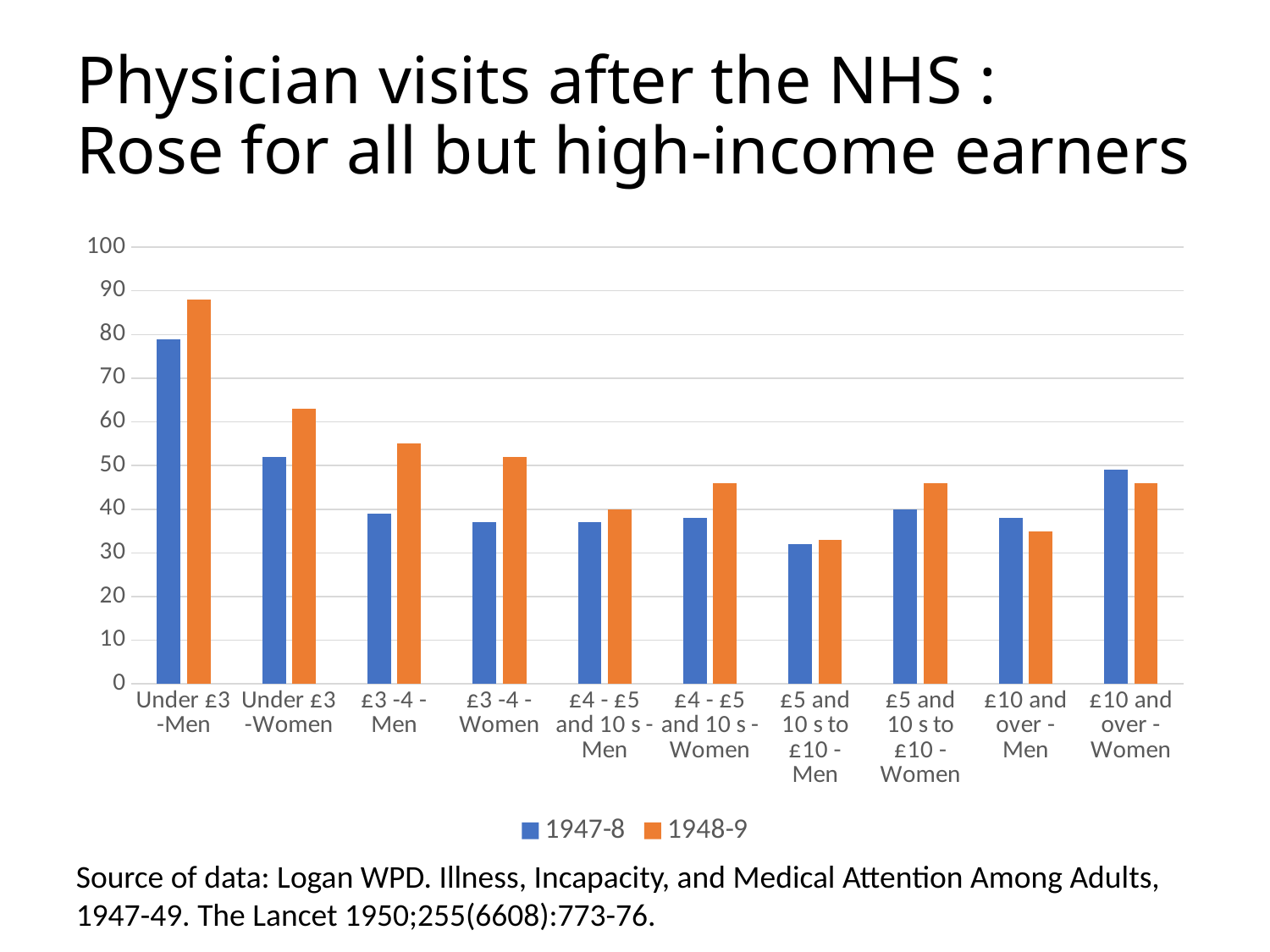
Which category has the highest 1948-9 bar? Under £3 -Men Is the 1948-9 value for £4 - £5 and 10 s - Women greater or less than 40? greater For Under £3 -Women, which series has the larger value, 1947-8 or 1948-9? 1948-9 What are the two series named in the legend? 1947-8 and 1948-9 Which category has the lowest 1947-8 bar? £5 and 10 s to £10 - Men Is the 1948-9 value for £10 and over - Men greater or less than 40? less What kind of chart is shown on the slide? bar chart How many series does the legend list? 2 Is the 1947-8 value for Under £3 -Men greater or less than 70? greater For £10 and over - Women, which series has the larger value, 1947-8 or 1948-9? 1947-8 How many income/sex categories are shown on the x axis? 10